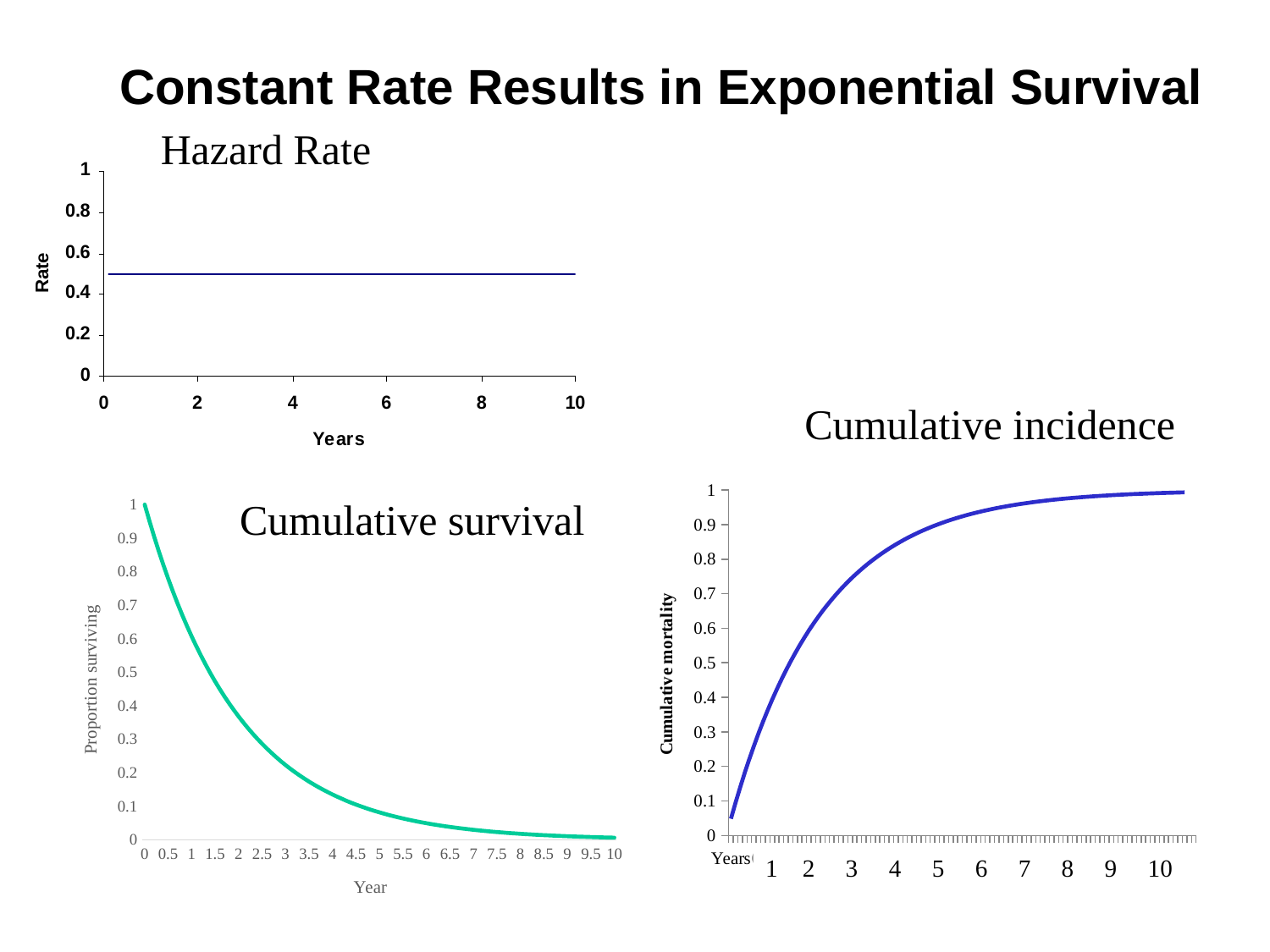
What is the y-axis label of the Cumulative survival chart? Proportion surviving In the Hazard Rate chart, is the plotted rate greater or less than 0.4? greater In the Cumulative survival chart, does the proportion surviving rise or fall as the years increase? fall In the Cumulative survival chart, what is the proportion surviving at year 0? 1 In the Cumulative incidence chart, does cumulative mortality rise or fall as the years increase? rise In the Cumulative incidence chart, is the cumulative mortality at year 2 greater or less than 0.5? greater What kind of chart is the Hazard Rate chart? line chart In the Hazard Rate chart, does the rate rise, fall, or stay constant across the years? stays constant In the Cumulative survival chart, is the proportion surviving at year 5 greater or less than 0.2? less What is the y-axis label of the Cumulative incidence chart? Cumulative mortality